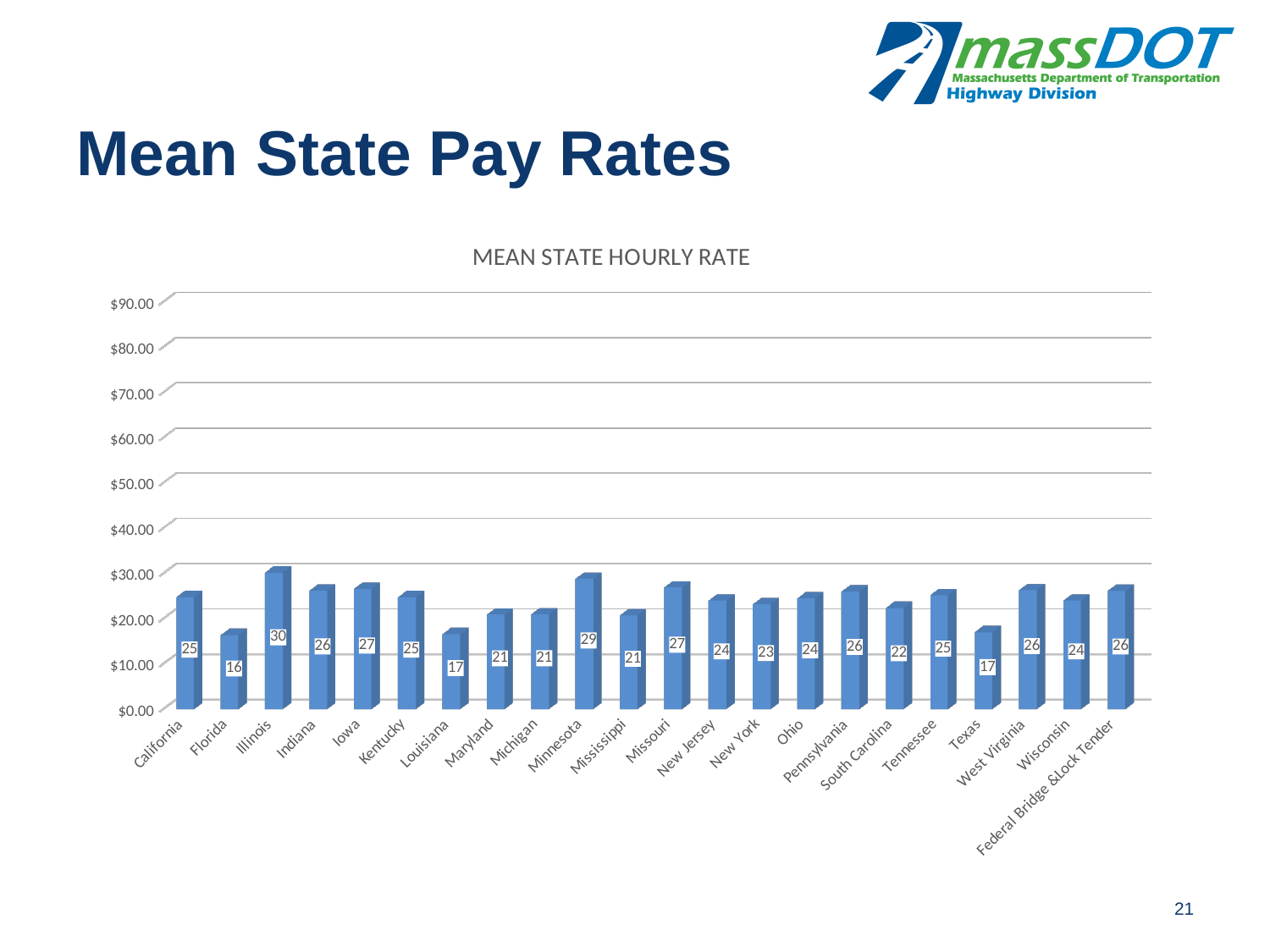
What is the mean hourly rate shown for Illinois? 30 Which state has the highest mean hourly rate? Illinois What is the mean hourly rate shown for Florida? 16 What kind of chart is shown on the slide? bar chart What value is labelled for Minnesota? 29 Which state has the lowest mean hourly rate? Florida Which has a higher mean hourly rate, Iowa or New York? Iowa What is the title of the chart? MEAN STATE HOURLY RATE What value is labelled for Federal Bridge &Lock Tender? 26 How many categories are shown on the x axis? 22 What is the difference between the values for Illinois and Florida? 14 Is the value for Texas greater or less than $20.00? less